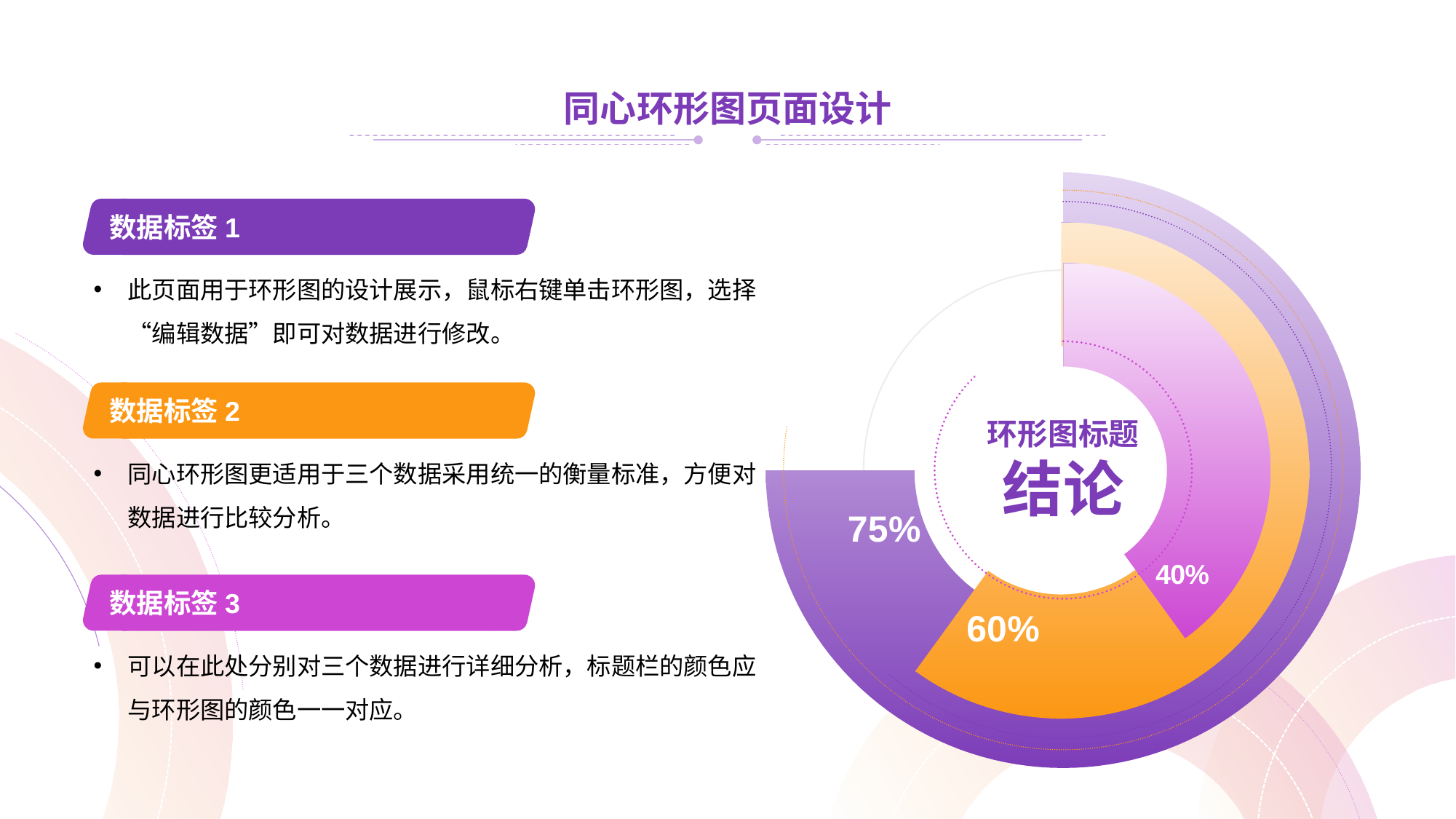
How many data values are plotted in the concentric donut chart? 3 Which ring has the lowest value in the concentric donut chart? The pink ring (数据标签 3), 40% What is the difference between the purple ring value and the pink ring value? 35% Which ring has the highest value in the concentric donut chart? The purple ring (数据标签 1), 75% What kind of chart is shown on the right of the slide? A concentric donut (ring) chart What is the difference between the orange ring value and the pink ring value? 20% What text appears in the centre of the donut chart? 环形图标题 结论 What value is shown for the orange ring (数据标签 2) in the concentric donut chart? 60% What value is shown for the purple ring (数据标签 1) in the concentric donut chart? 75% Which is larger, the value of the orange ring or the value of the pink ring? The orange ring (60%) Which colour is the outermost ring of the donut chart? Purple What value is shown for the pink ring (数据标签 3) in the concentric donut chart? 40%